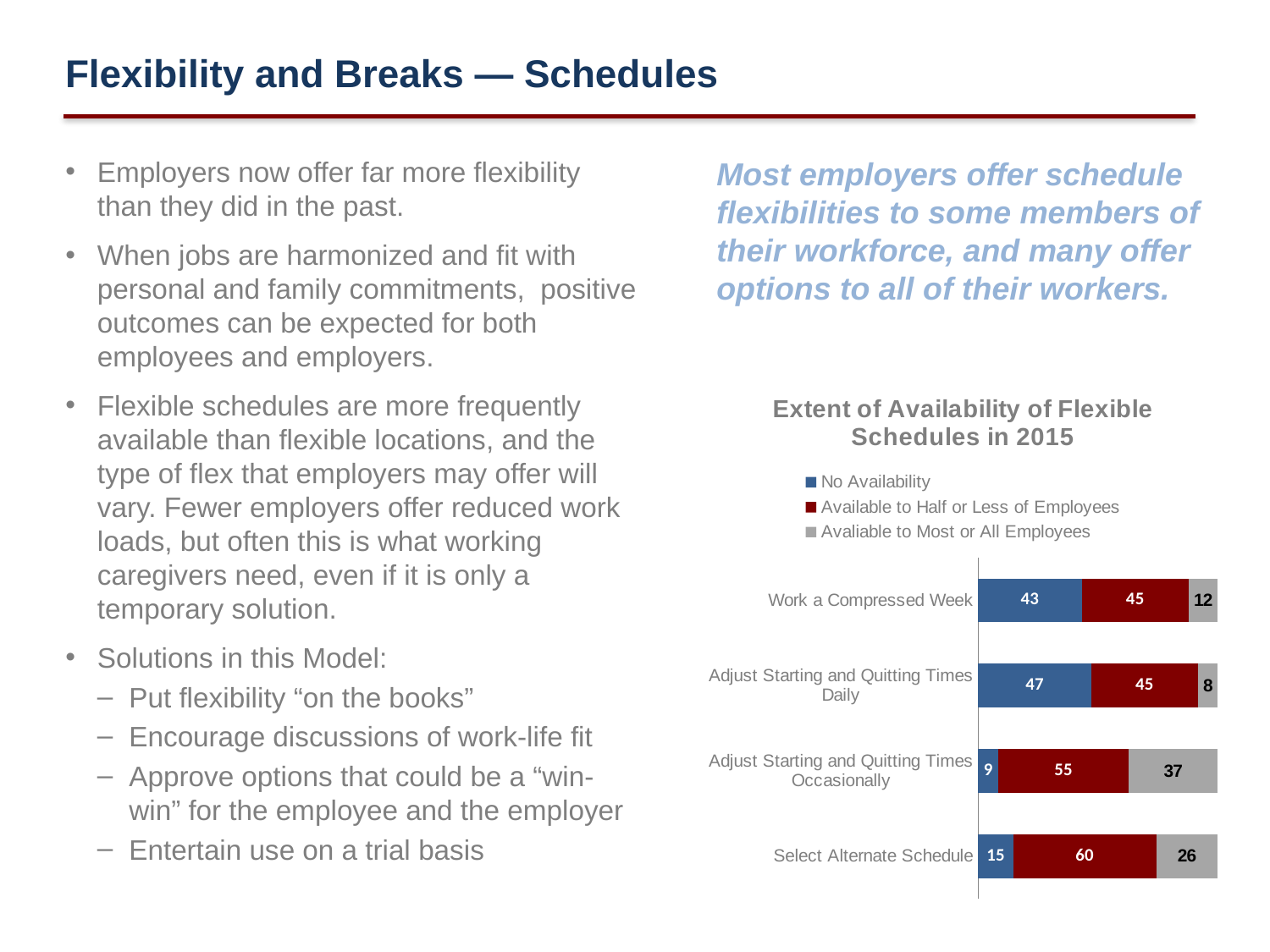
What is the difference between the "Available to Half or Less of Employees" values for "Select Alternate Schedule" and "Work a Compressed Week"? 15 Which category has the lowest "Avaliable to Most or All Employees" value? Adjust Starting and Quitting Times Daily Which colour represents "Available to Half or Less of Employees" in the chart? Dark red What type of chart is shown under the title "Extent of Availability of Flexible Schedules in 2015"? Stacked bar chart What is the "Available to Half or Less of Employees" value for "Select Alternate Schedule"? 60 How many categories are shown in the "Extent of Availability of Flexible Schedules in 2015" chart? 4 What is the "Avaliable to Most or All Employees" value for "Adjust Starting and Quitting Times Occasionally"? 37 How many series does the legend of the "Extent of Availability of Flexible Schedules in 2015" chart list? 3 Which category has the highest "No Availability" value? Adjust Starting and Quitting Times Daily Which is larger: the "No Availability" value for "Select Alternate Schedule" or for "Adjust Starting and Quitting Times Occasionally"? Select Alternate Schedule What is the total of the stacked bar for "Adjust Starting and Quitting Times Occasionally"? 101 What is the "No Availability" value for "Work a Compressed Week"? 43